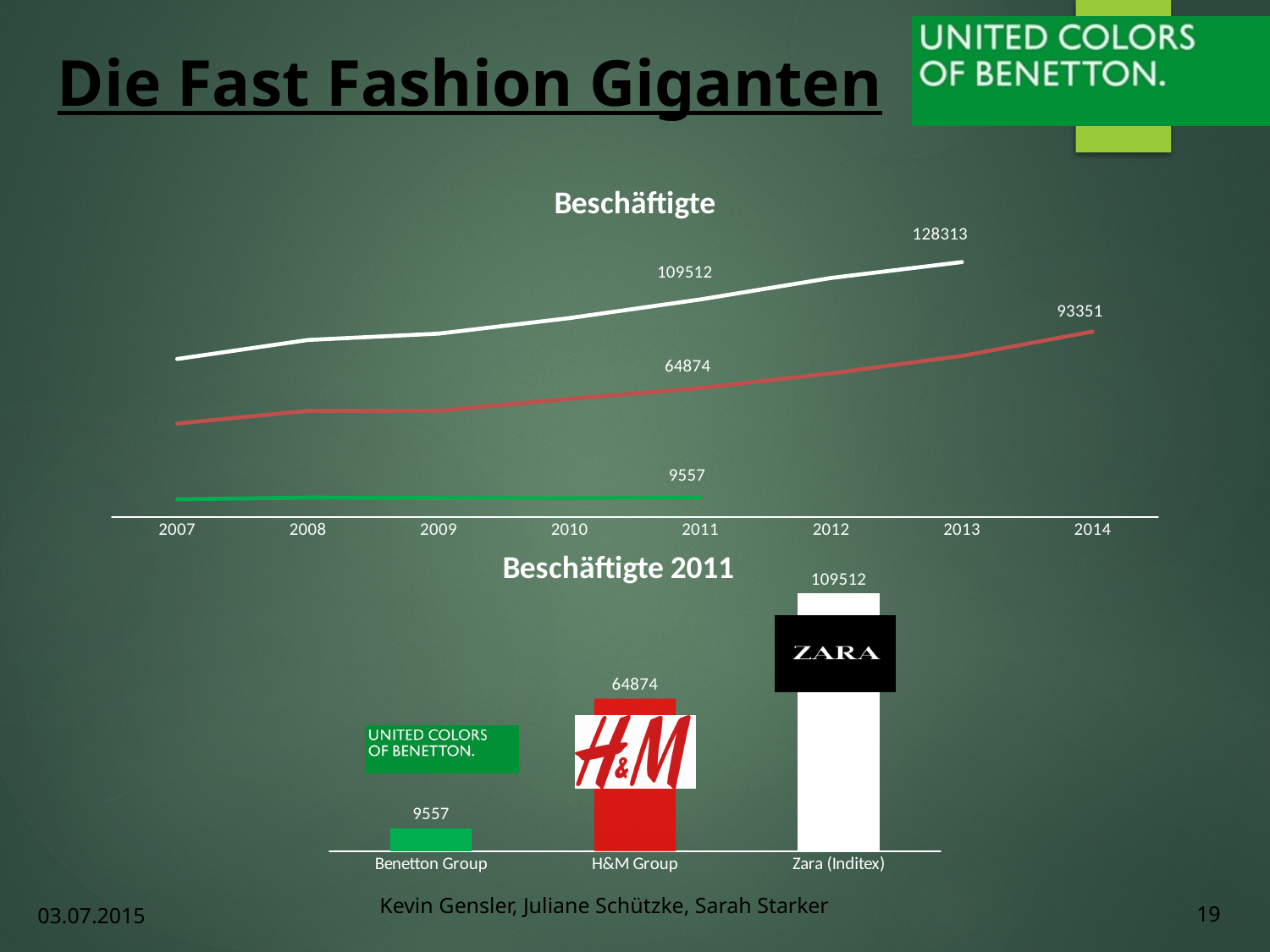
What kind of chart is the 'Beschäftigte 2011' chart? bar chart In the 'Beschäftigte 2011' chart, what is the difference between Zara (Inditex) and H&M Group? 44638 In the 'Beschäftigte' line chart, what value is labelled on the white line at 2013? 128313 In the 'Beschäftigte' line chart, what value is labelled on the red line at 2014? 93351 In the 'Beschäftigte' line chart, does the white line rise or fall from 2007 to 2013? rise In the 'Beschäftigte 2011' chart, how many categories are shown? 3 In the 'Beschäftigte 2011' chart, which is larger, H&M Group or Benetton Group? H&M Group In the 'Beschäftigte 2011' chart, which category has the highest value? Zara (Inditex) In the 'Beschäftigte 2011' chart, which category has the lowest value? Benetton Group In the 'Beschäftigte 2011' chart, what is the value for Zara (Inditex)? 109512 In the 'Beschäftigte 2011' chart, what is the value for Benetton Group? 9557 In the 'Beschäftigte 2011' chart, what is the value for H&M Group? 64874